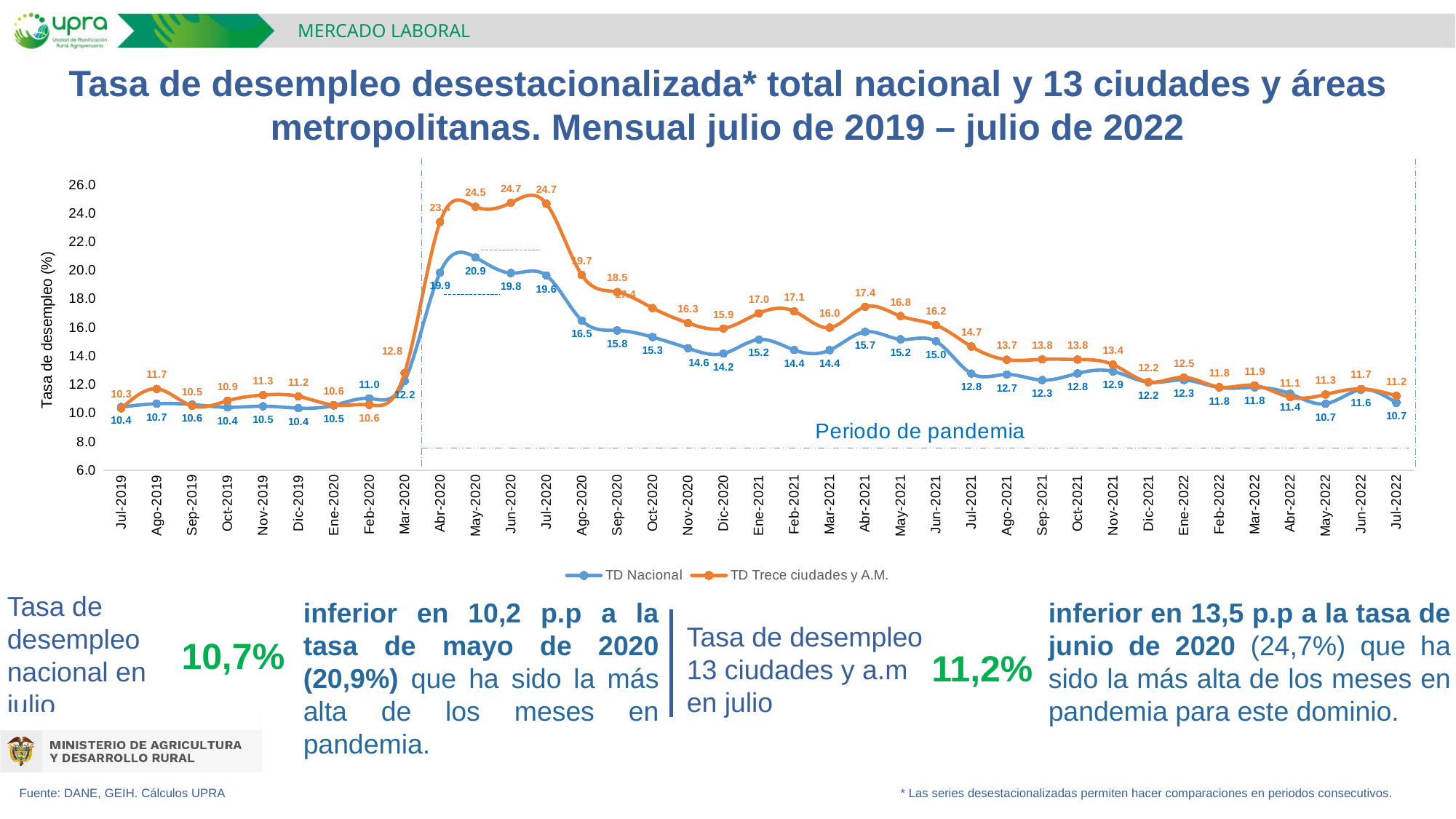
What kind of chart is shown on the slide? Line chart What is the difference between TD Trece ciudades y A.M. and TD Nacional in Jul-2022? 0.5 Does TD Nacional rise or fall from Jul-2020 to Dic-2020? Fall What label is written inside the dashed box on the chart? Periodo de pandemia What is the value of TD Trece ciudades y A.M. in May-2020? 24.5 In Ago-2019, which series has the higher value, TD Nacional or TD Trece ciudades y A.M.? TD Trece ciudades y A.M. How many series does the legend list? 2 In which month does TD Trece ciudades y A.M. reach its lowest value? Jul-2019 What is the difference between the TD Nacional value in May-2020 and in Jul-2022? 10.2 What is the value of TD Trece ciudades y A.M. in Jul-2022? 11.2 What is the value of TD Nacional in Jul-2022? 10.7 In which month does TD Nacional reach its highest value? May-2020